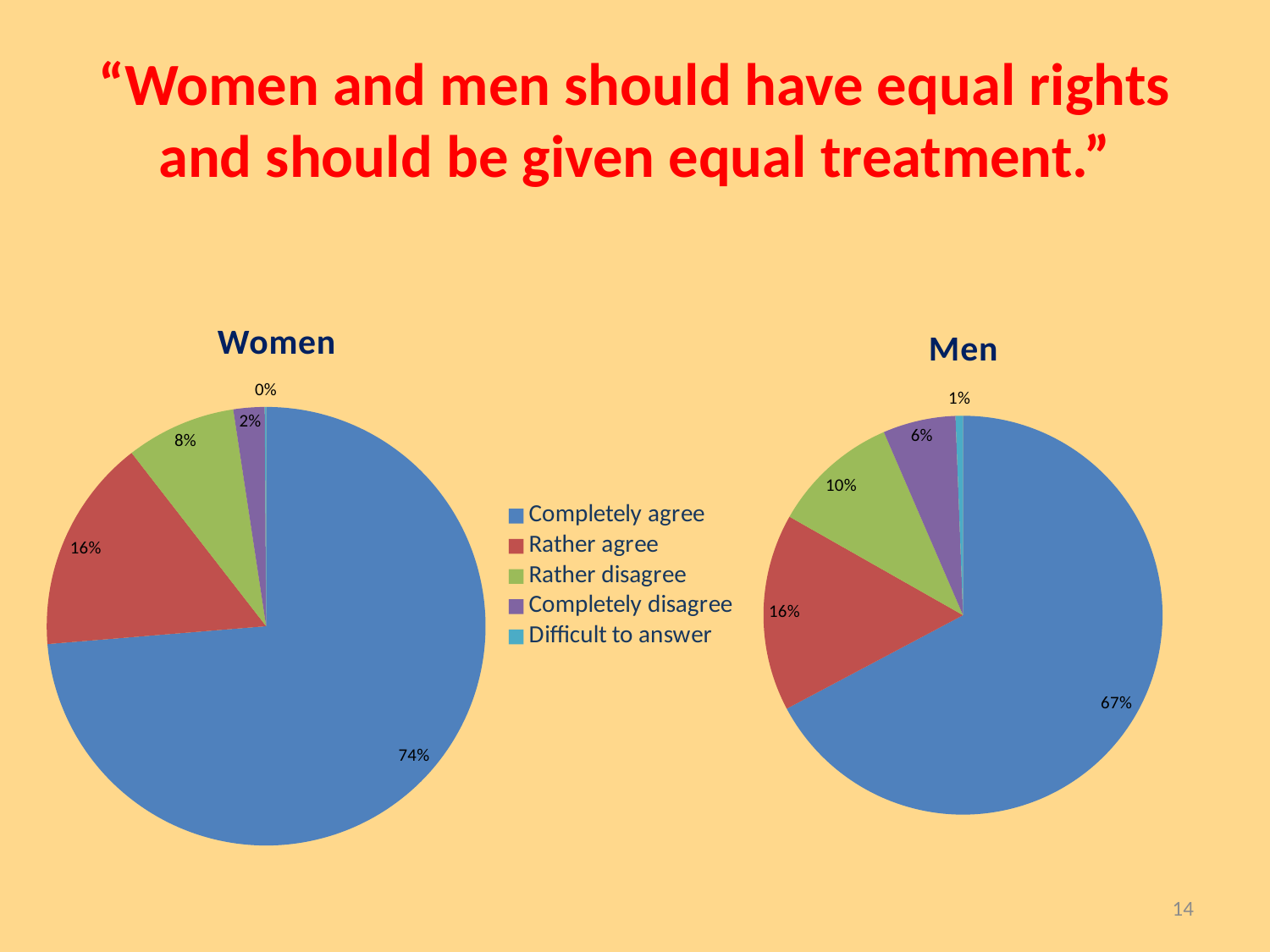
What type of chart is used to show the Women and Men responses? Pie chart In the Men pie chart, what percentage of respondents completely agree? 67% In the Women pie chart, which response category has the largest share? Completely agree In the Men pie chart, what percentage of respondents rather disagree? 10% How many response categories does the legend list? 5 Which is larger: the 'Rather disagree' share in the Men chart or in the Women chart? Men In the Women pie chart, which response category has the smallest share? Difficult to answer In the Men pie chart, what percentage found it difficult to answer? 1% What is the difference between the 'Completely agree' share for Women and for Men? 7% In the Women pie chart, what percentage of respondents completely agree? 74% In the Women pie chart, what percentage of respondents completely disagree? 2% What colour represents 'Rather agree' in the pie charts? Red